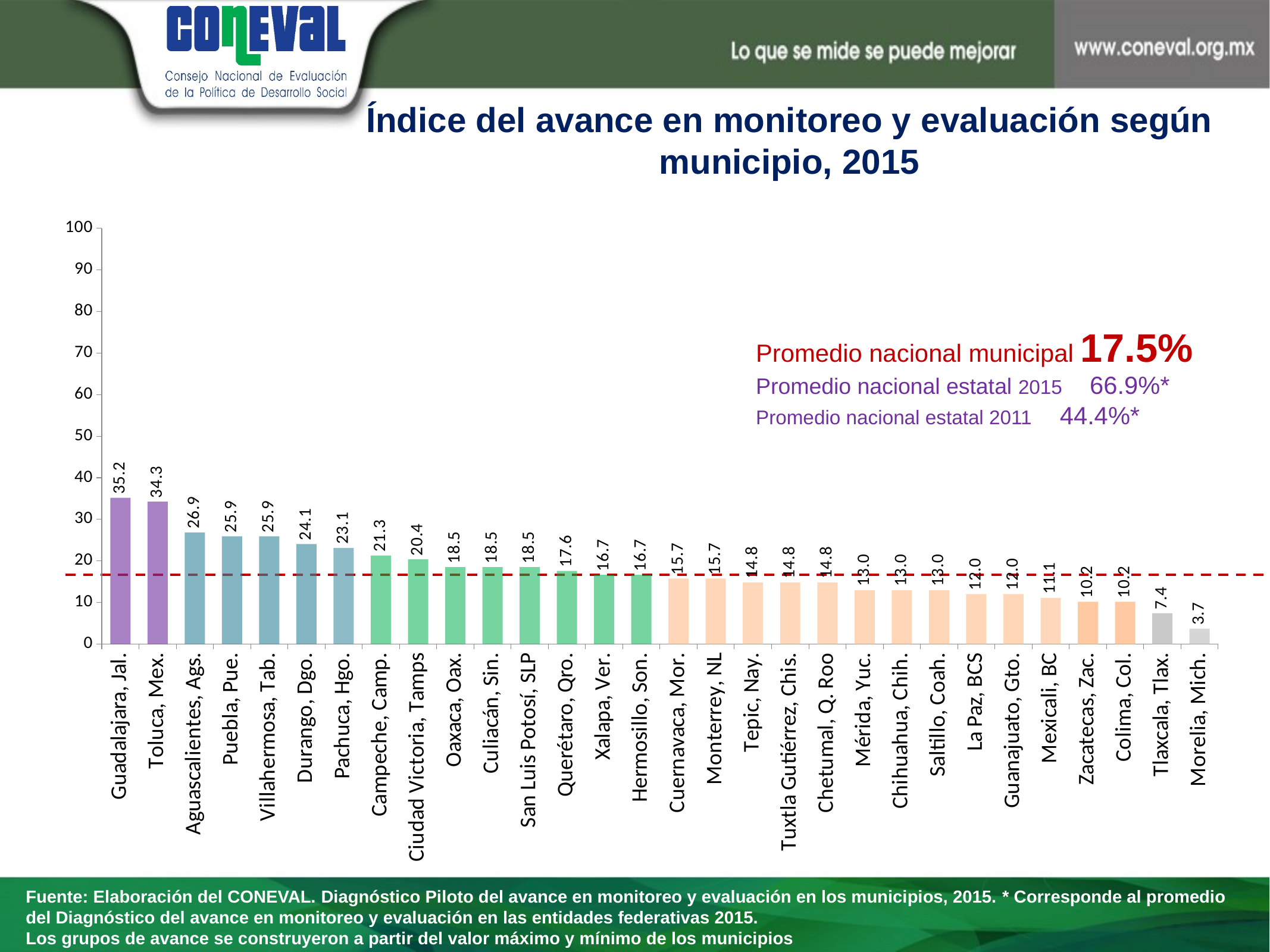
What is the national municipal average (Promedio nacional municipal) shown on the slide? 17.5% What is the value for Morelia, Mich.? 3.7 Which municipality has the lowest value? Morelia, Mich. What is the value for Guadalajara, Jal.? 35.2 Which has a larger value, Aguascalientes, Ags. or Durango, Dgo.? Aguascalientes, Ags. What is the value for Campeche, Camp.? 21.3 What is the difference between the values for Tlaxcala, Tlax. and Morelia, Mich.? 3.7 What is the difference between the values for Guadalajara, Jal. and Toluca, Mex.? 0.9 Is the value for Pachuca, Hgo. greater or less than 20? greater What kind of chart is shown on the slide? bar chart How many municipalities are shown in the chart? 30 Which municipality has the highest value? Guadalajara, Jal.